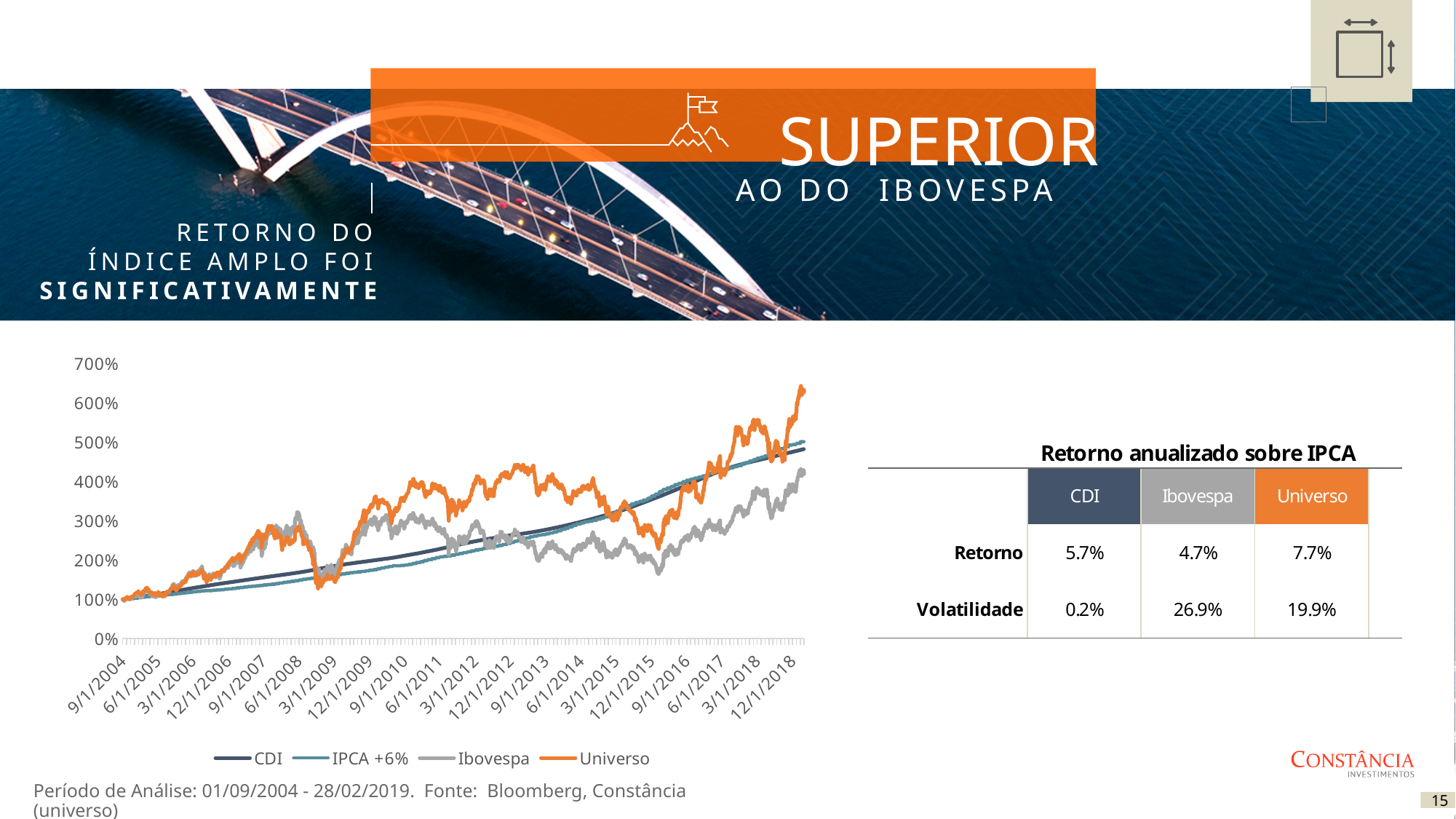
Which series reaches the highest value at the end of the chart? Universo Which series has the lowest value at the end of the chart? Ibovespa Is the value of the CDI series at 12/1/2018 greater or less than 400%? greater Is the value of the Ibovespa series around 3/1/2009 greater or less than 200%? less How many series does the chart legend list? 4 What value do all the series start at on 9/1/2004? 100% What kind of chart is shown on the slide? line chart At the end of the period (12/1/2018), which series is higher: Universo or Ibovespa? Universo Does the Universo series overall rise or fall from 9/1/2004 to 12/1/2018? rise What colour is the Universo line in the chart? orange Is the value of the Ibovespa series at 12/1/2018 greater or less than 500%? less